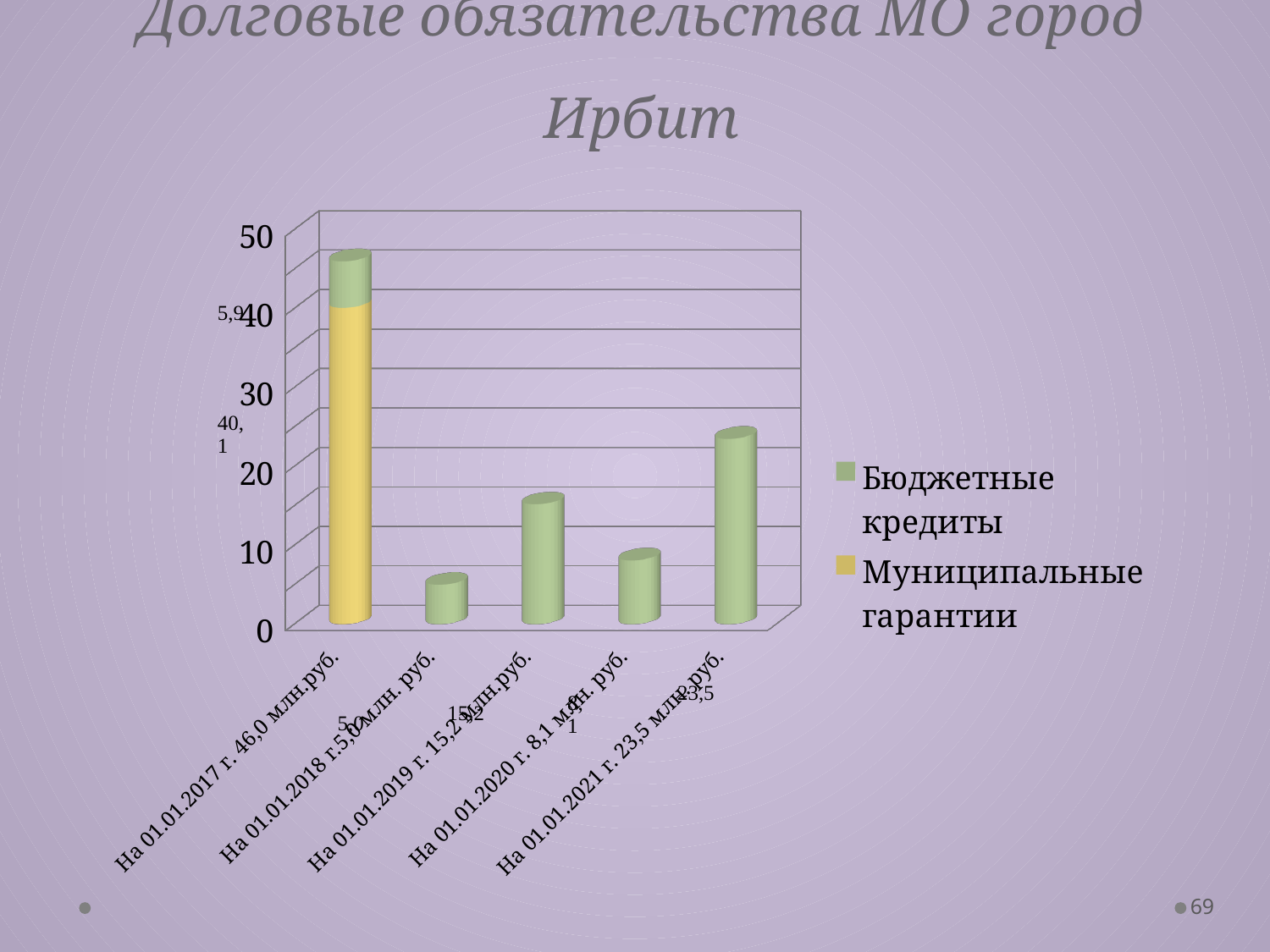
What is the total of the stacked bar for На 01.01.2017 г.? 46,0 How many series does the legend list? 2 Which series is shown in yellow in the legend? Муниципальные гарантии What kind of chart is shown on the slide? bar chart Which is larger, the bar for На 01.01.2019 г. or the bar for На 01.01.2020 г.? На 01.01.2019 г. Which date has the lowest total debt? На 01.01.2018 г. How many categories (dates) are shown on the x axis? 5 What is the value of Бюджетные кредиты for На 01.01.2017 г.? 5,9 Is the value for На 01.01.2021 г. greater or less than 20? greater What is the value of Муниципальные гарантии for На 01.01.2017 г.? 40,1 Which date has the highest total debt? На 01.01.2017 г. Is the value for На 01.01.2020 г. greater or less than 10? less